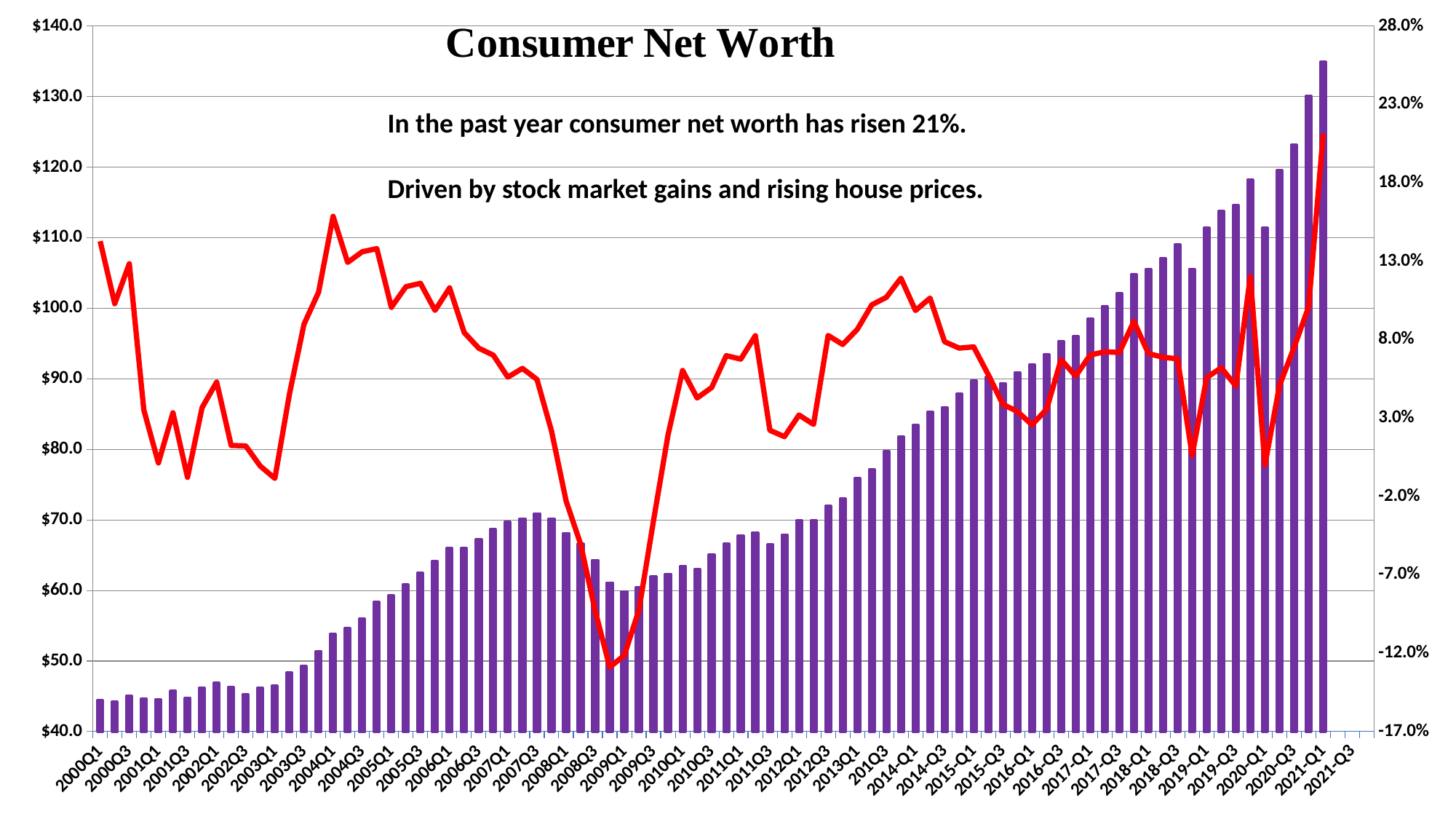
According to the text on the chart, by how much has consumer net worth risen in the past year? 21% Is the purple bar for 2018-Q1 greater or less than $100.0? greater Is the red line value at 2009Q1 greater or less than -10.0% on the right axis? less What kind of chart is shown on the slide? A combination bar and line chart Overall, do the purple bars rise or fall from 2000Q1 to 2021-Q1? rise What is the title of the chart? Consumer Net Worth Is the purple bar for 2014-Q1 greater or less than $80.0? greater Which has the taller purple bar, 2007Q3 or 2009Q1? 2007Q3 Which quarter has the tallest purple bar? 2021-Q1